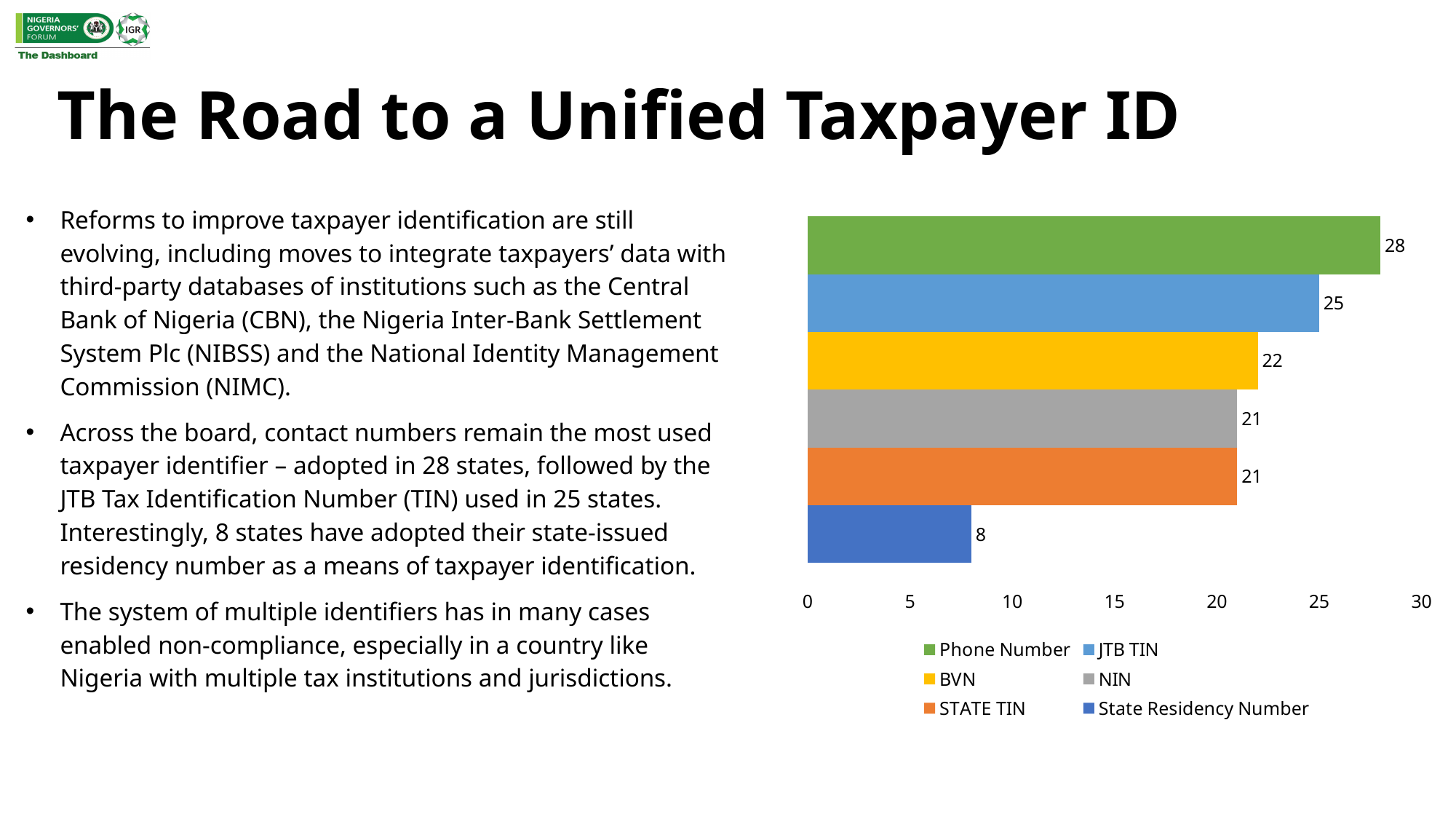
What value is shown for JTB TIN? 25 What value is shown for BVN? 22 Which identifier has the highest value in the chart? Phone Number What is the difference between the values for BVN and State Residency Number? 14 How many bars are plotted in the chart? 6 Which is larger, the value for JTB TIN or the value for BVN? JTB TIN What value is shown for Phone Number? 28 How many entries does the legend list? 6 What value is shown for State Residency Number? 8 What kind of chart is shown on the slide? Bar chart Which identifier has the lowest value in the chart? State Residency Number What is the difference between the values for Phone Number and JTB TIN? 3